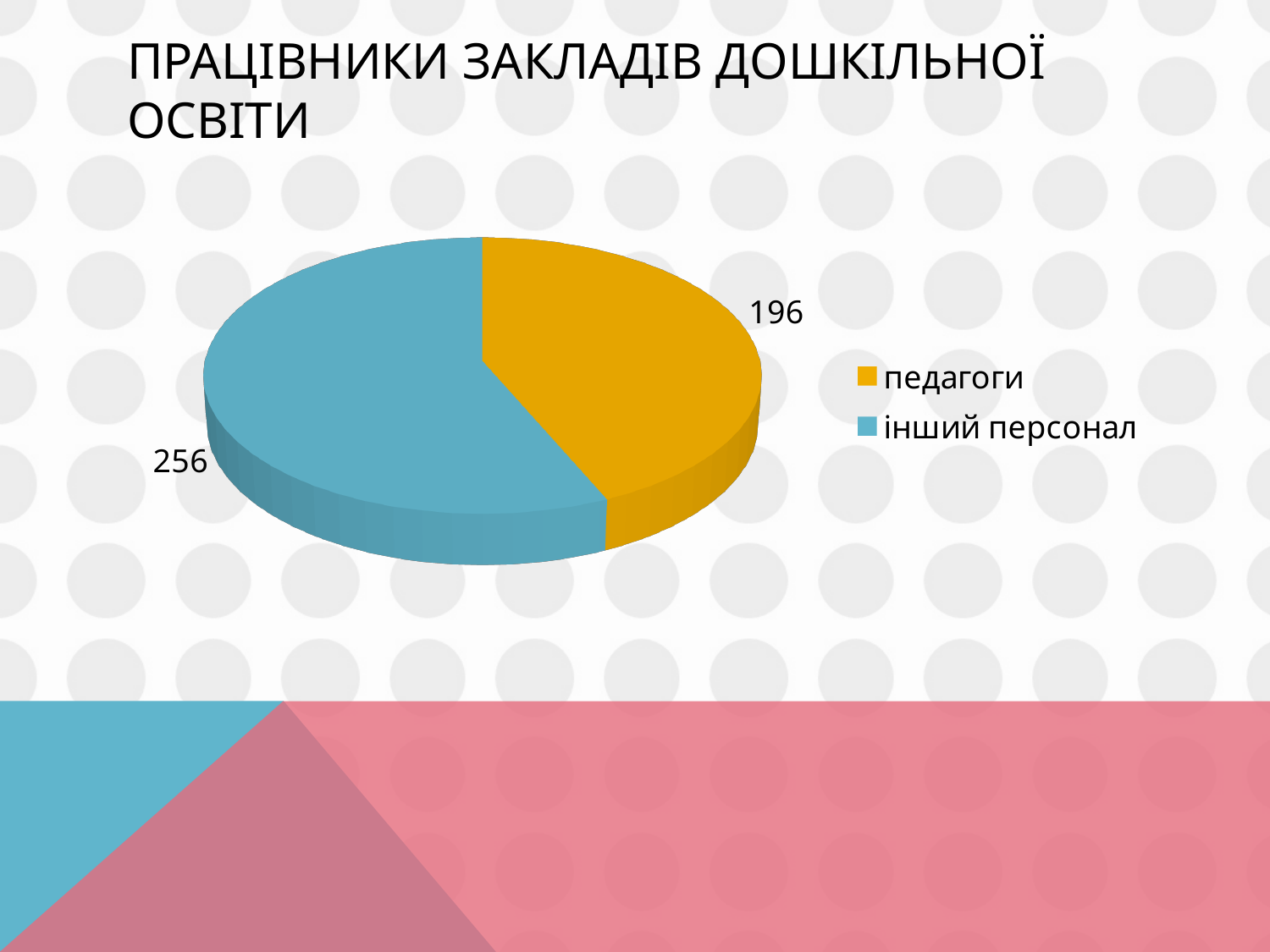
What type of chart is shown on the slide? Pie chart What is the value for інший персонал? 256 Which category has the smallest slice of the pie? педагоги What is the difference between the values for інший персонал and педагоги? 60 What is the value for педагоги? 196 What share of the pie does педагоги represent, to the nearest whole percent? 43% Which is larger, the value for педагоги or the value for інший персонал? інший персонал What colour is the slice for інший персонал? Blue Which category has the largest slice of the pie? інший персонал How many categories does the pie chart have? 2 What is the title of the slide containing the chart? ПРАЦІВНИКИ ЗАКЛАДІВ ДОШКІЛЬНОЇ ОСВІТИ What is the total of all slices in the pie chart? 452